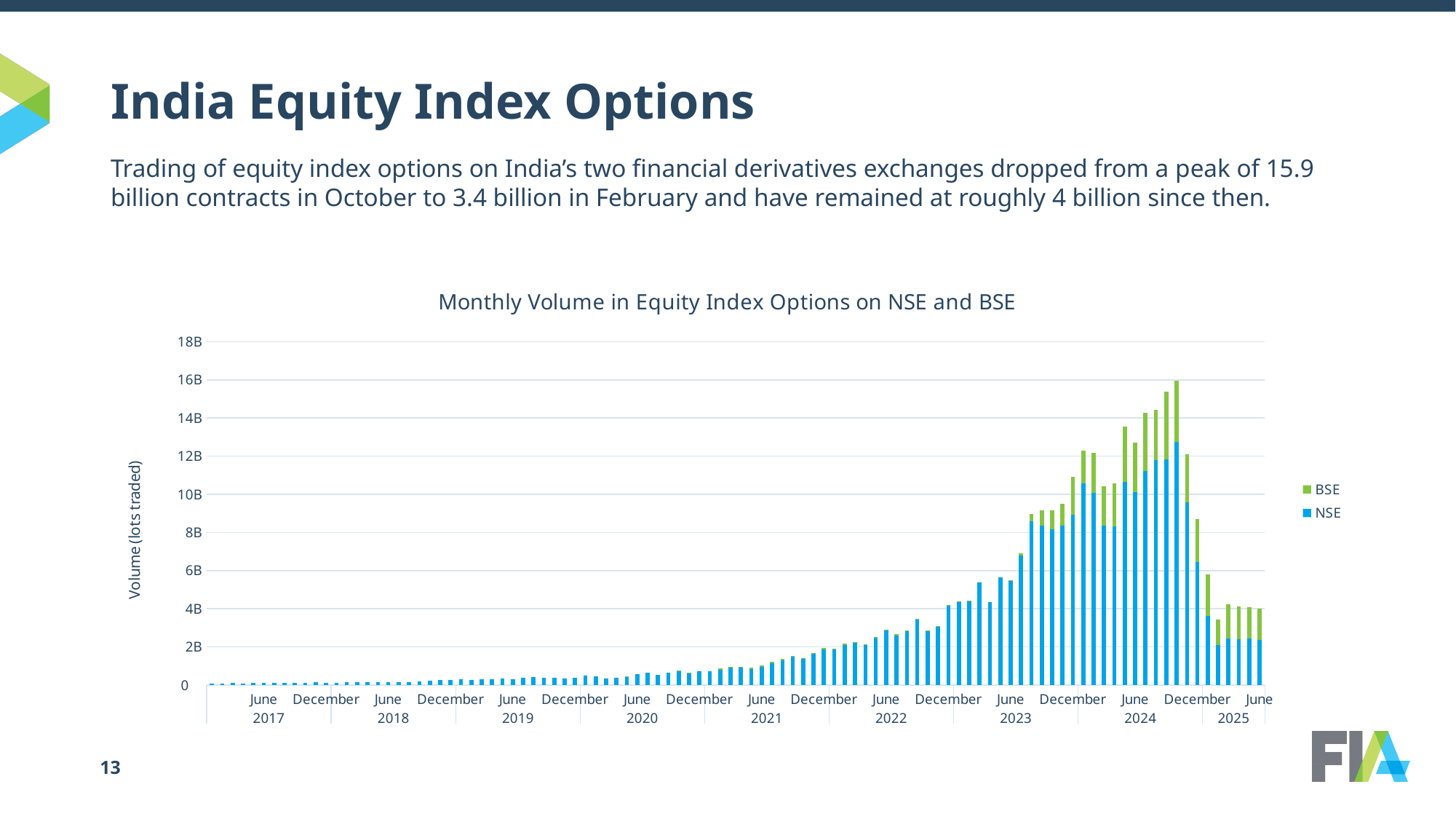
Is the total value for June 2023 greater or less than 4B? greater How many series does the legend of the chart list? 2 What is the title of the chart? Monthly Volume in Equity Index Options on NSE and BSE What kind of chart is shown on the slide? Stacked bar chart What is the label on the vertical axis of the chart? Volume (lots traded) In which year does the tallest bar in the chart occur? 2024 Which is larger, the total bar for December 2023 or the total bar for December 2024? December 2023 Is the total value for June 2020 greater or less than 2B? less Do the monthly volumes generally rise or fall from 2017 through 2024? rise Is the total value for June 2021 greater or less than 2B? less Which is larger, the total bar for June 2024 or the total bar for June 2025? June 2024